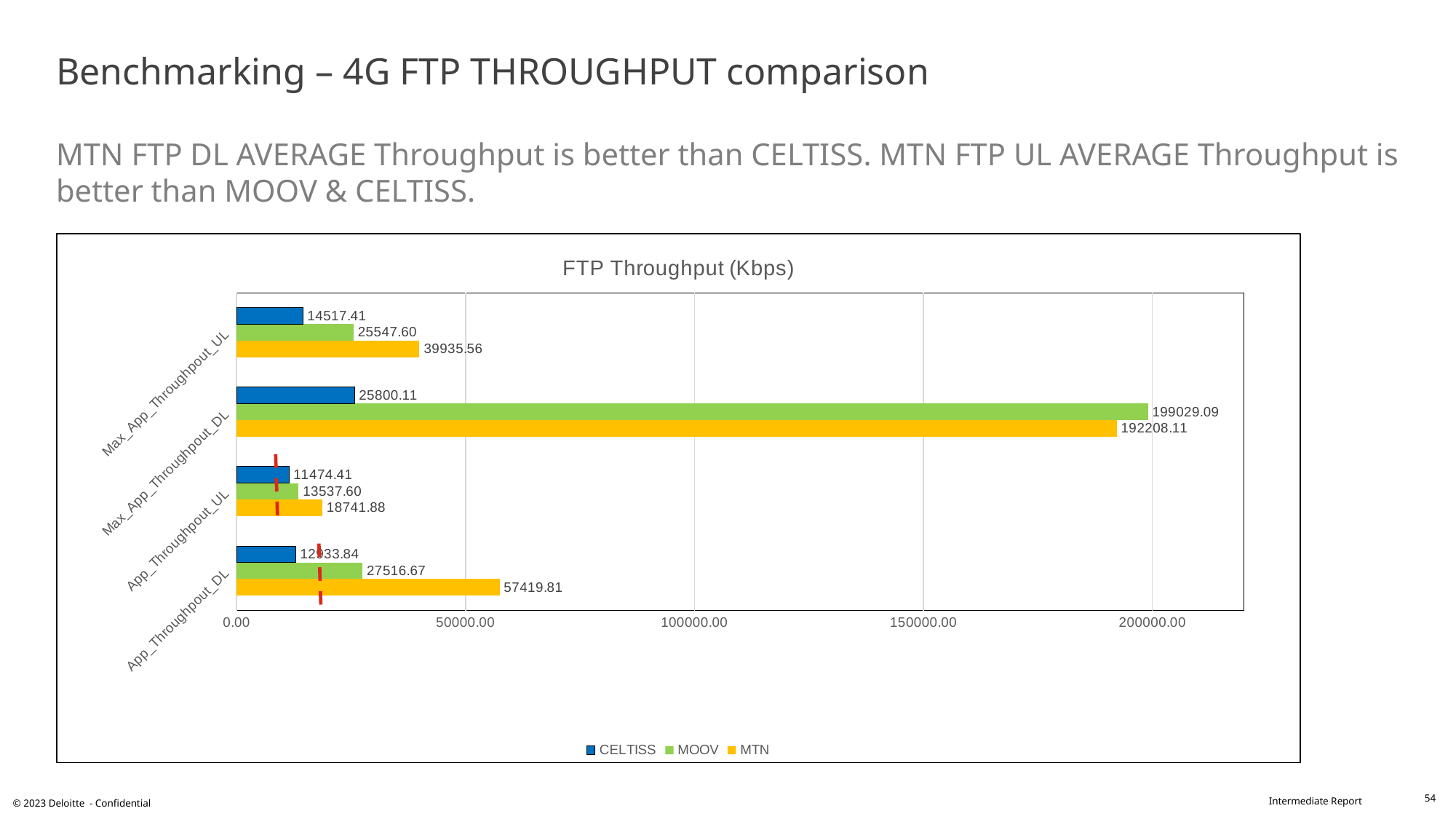
What type of chart is shown on the slide? Bar chart What is the MTN value for App_Throughpout_DL? 57419.81 What is the CELTISS value for Max_App_Throughpout_UL? 14517.41 Is the MTN value for App_Throughpout_DL greater or less than 50000.00? greater What is the difference between the MOOV and MTN values for Max_App_Throughpout_DL? 6820.98 Which is larger for App_Throughpout_UL: the MOOV value or the MTN value? MTN How many series does the legend list? 3 What is the MOOV value for Max_App_Throughpout_DL? 199029.09 Which operator has the lowest value for Max_App_Throughpout_UL? CELTISS Which operator has the highest value for Max_App_Throughpout_DL? MOOV How many categories are shown on the vertical axis of the chart? 4 What is the MTN value for App_Throughpout_UL? 18741.88